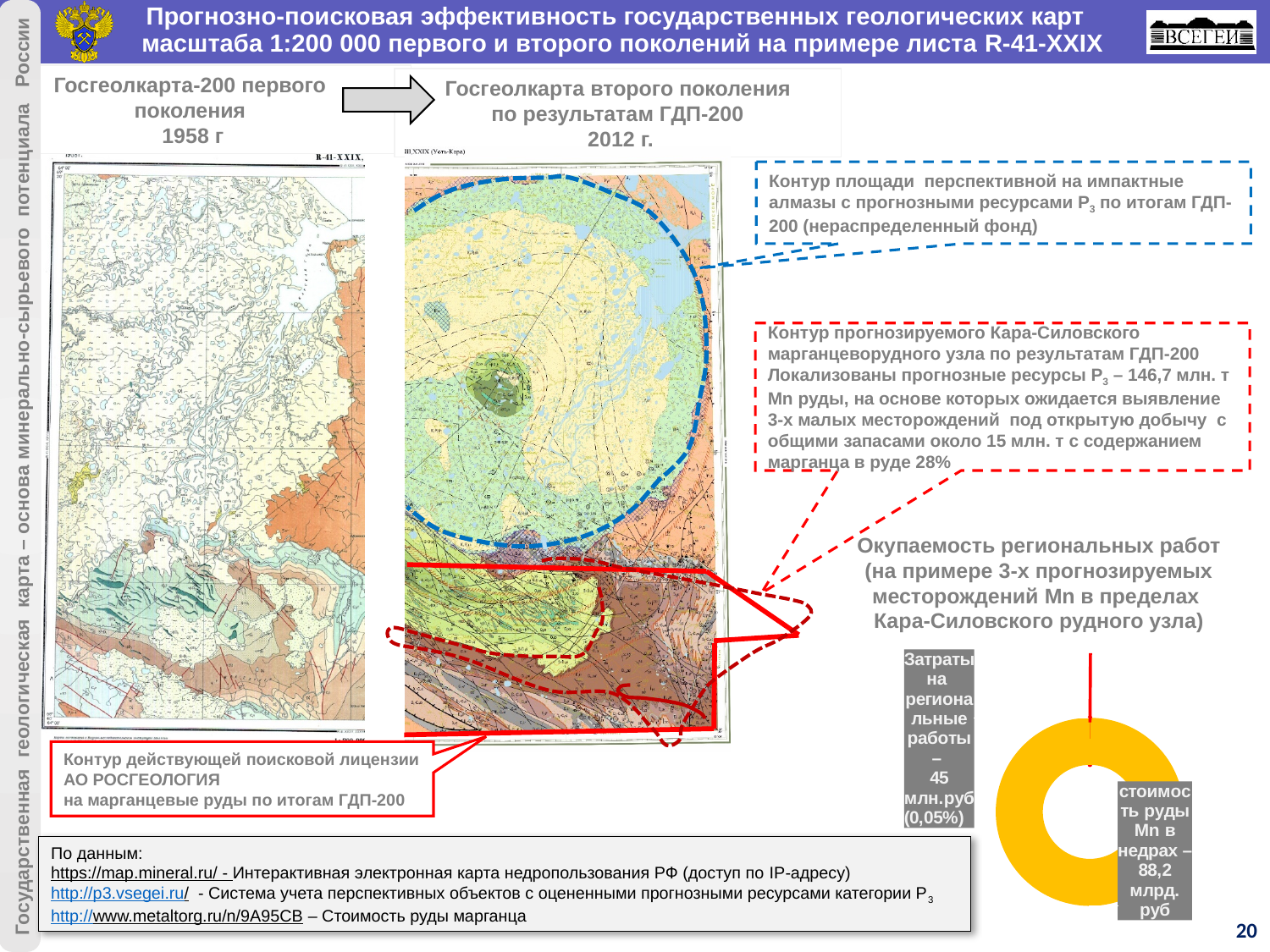
What colour is the large segment of the doughnut chart? Yellow What kind of chart is shown at the bottom right of the slide? Doughnut (pie) chart Which segment of the doughnut chart is the largest? стоимость руды Mn в недрах – 88,2 млрд. руб What share of the doughnut chart do the regional work costs ('Затраты на региональные работы') represent? 0,05% Which segment of the doughnut chart is the smallest? Затраты на региональные работы – 45 млн.руб How many segments does the doughnut chart at the bottom right of the slide have? 2 In the doughnut chart, which is larger: the cost of regional work or the value of Mn ore in the subsoil? стоимость руды Mn в недрах In the doughnut chart, what is the value for 'стоимость руды Mn в недрах'? 88,2 млрд. руб What is the title of the doughnut chart at the bottom right of the slide? Окупаемость региональных работ (на примере 3-х прогнозируемых месторождений Mn в пределах Кара-Силовского рудного узла) In the doughnut chart, what is the value for 'Затраты на региональные работы'? 45 млн.руб